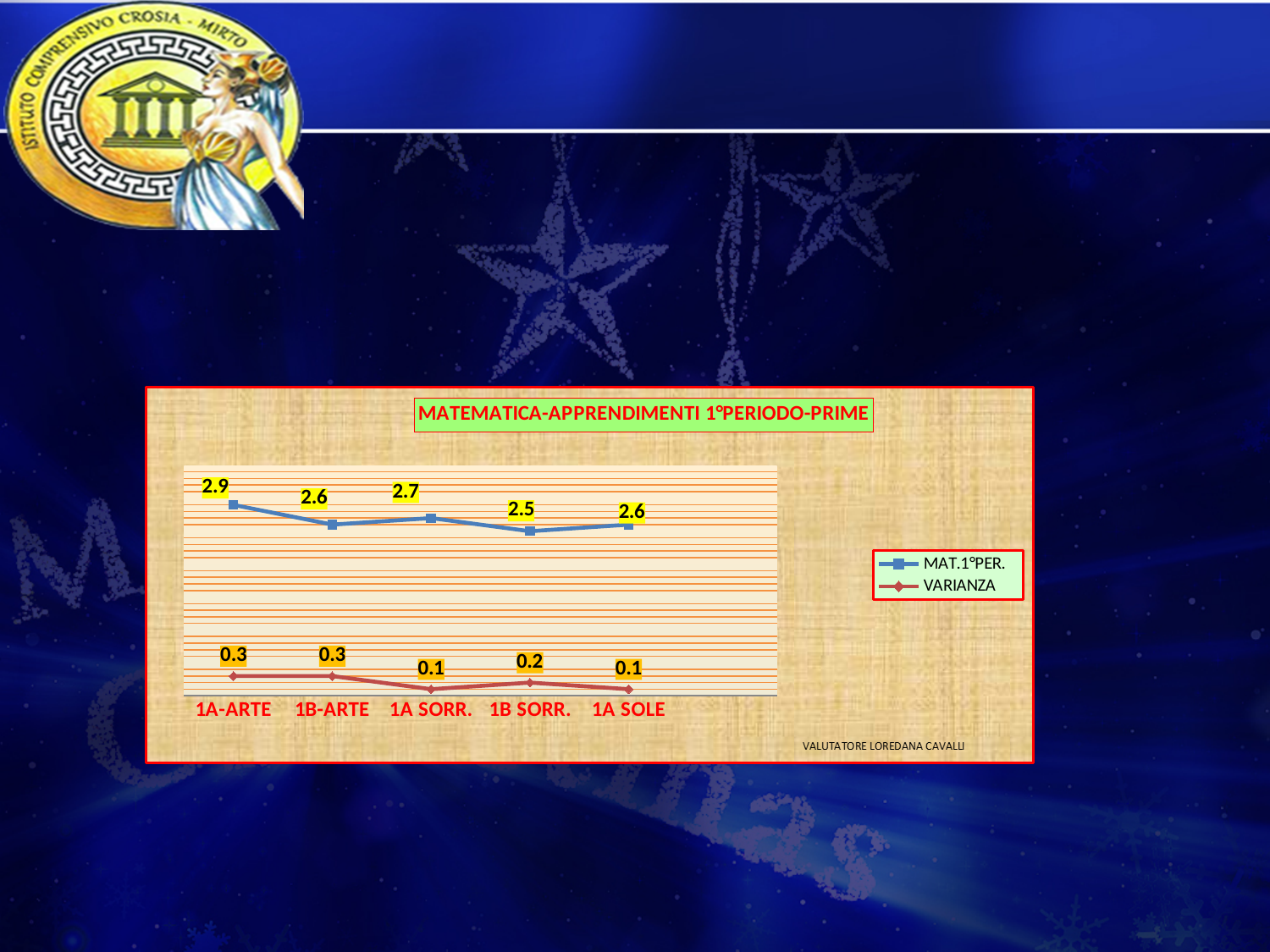
Which category has the lowest MAT.1°PER. value? 1B SORR. What is the MAT.1°PER. value for 1A SOLE? 2.6 Which series is drawn in red? VARIANZA What is the MAT.1°PER. value for 1A-ARTE? 2.9 How many categories are shown on the x axis? 5 Which category has the highest MAT.1°PER. value? 1A-ARTE How many series does the legend list? 2 What is the VARIANZA value for 1B SORR.? 0.2 Which is larger, the VARIANZA value for 1A-ARTE or for 1A SORR.? 1A-ARTE What is the title of the chart? MATEMATICA-APPRENDIMENTI 1°PERIODO-PRIME What type of chart is shown on the slide? line chart What is the difference between the MAT.1°PER. values for 1A-ARTE and 1B SORR.? 0.4